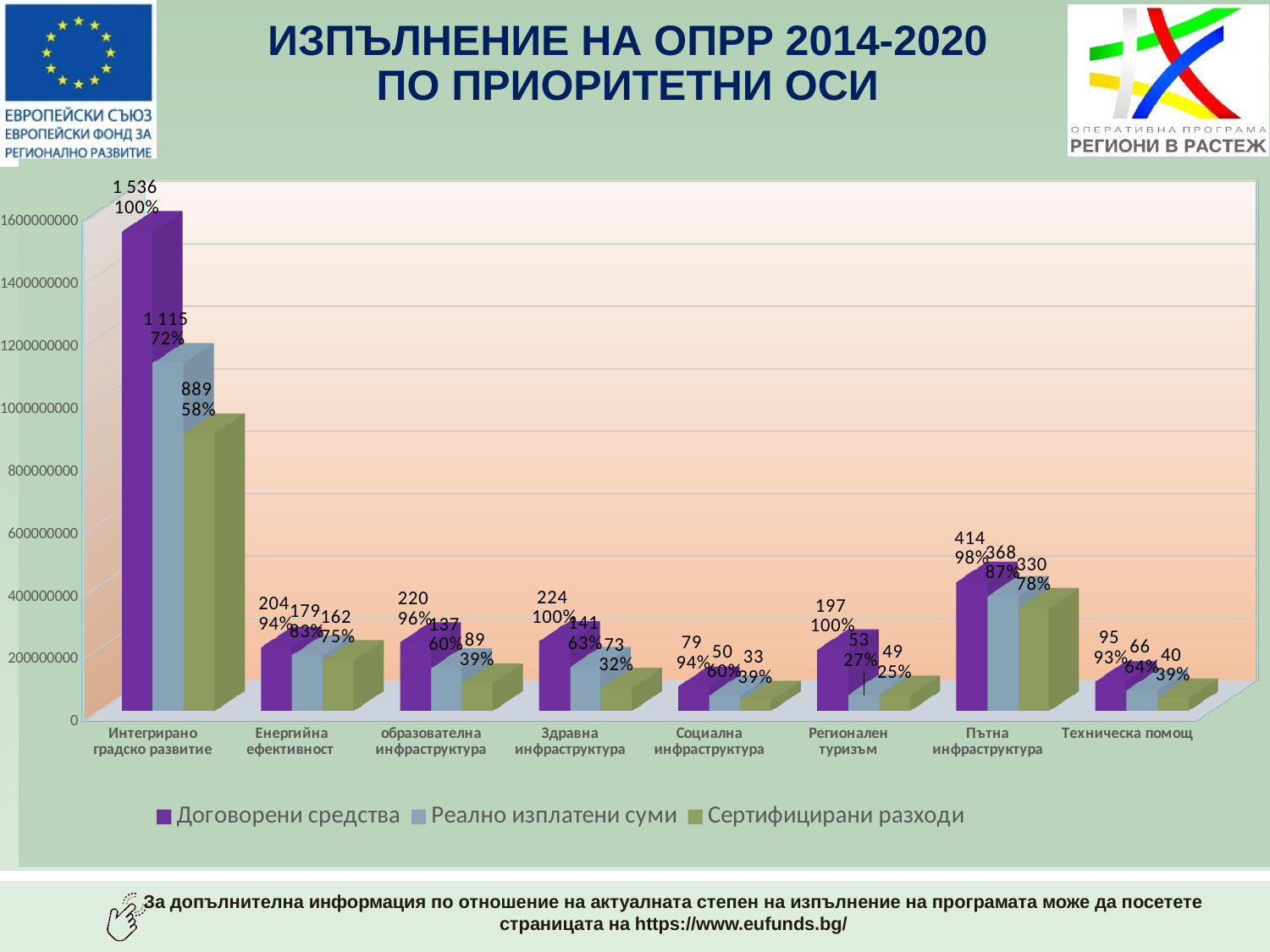
Which series is shown in purple in the legend? Договорени средства What is the value of Реално изплатени суми for Техническа помощ? 66 What percentage is shown for Реално изплатени суми in Регионален туризъм? 27% What kind of chart is shown on the slide? Bar chart How many categories are shown on the x axis? 8 How many series does the legend list? 3 Which category has the lowest value for Сертифицирани разходи? Социална инфраструктура What is the value of Сертифицирани разходи for Интегрирано градско развитие? 889 Which is larger: Реално изплатени суми for Енергийна ефективност or for образователна инфраструктура? Енергийна ефективност Which category has the highest value for Договорени средства? Интегрирано градско развитие What is the difference between Договорени средства and Реално изплатени суми for Здравна инфраструктура? 83 What is the value of Договорени средства for Пътна инфраструктура? 414